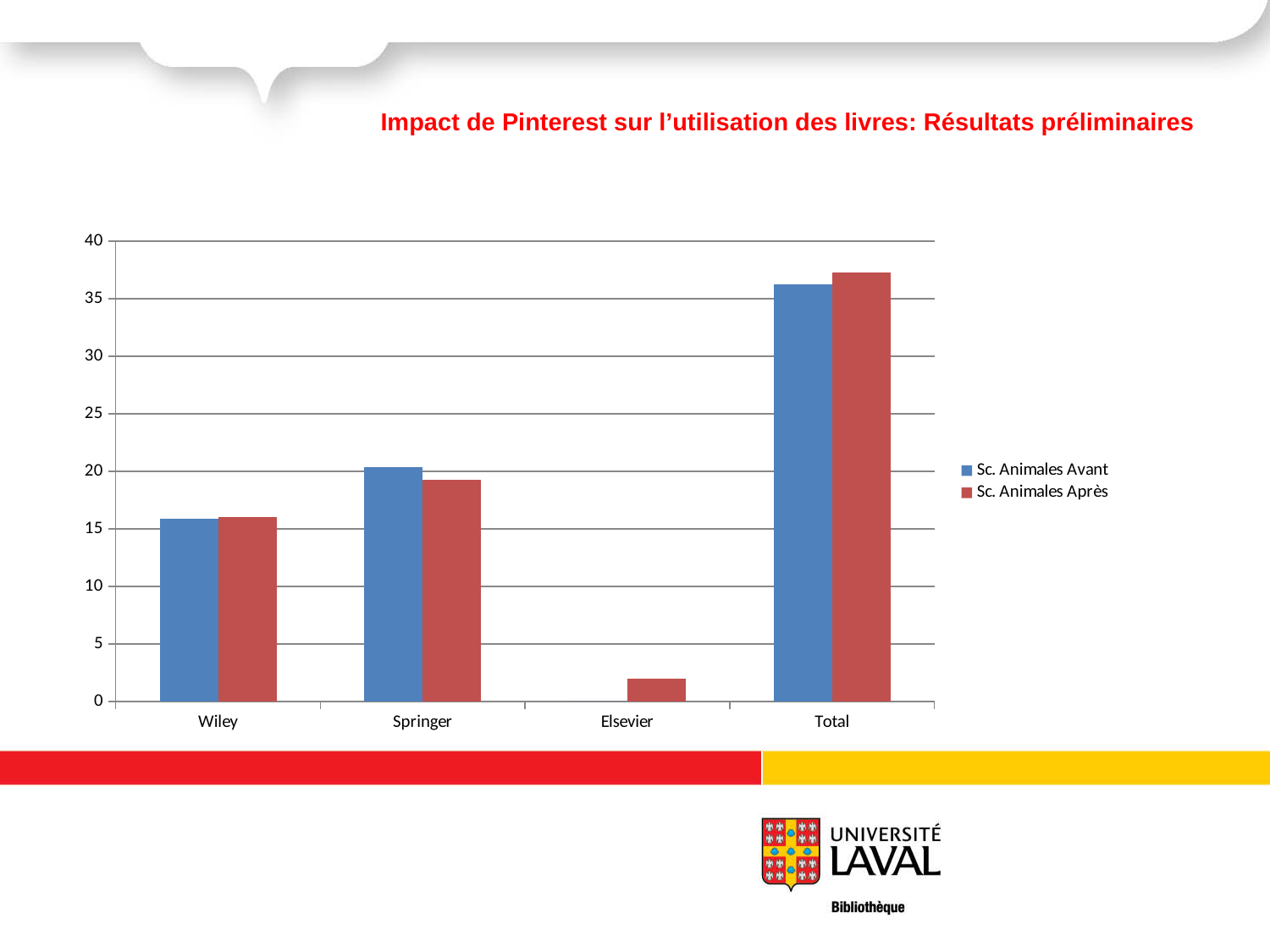
Which category has the highest value for Sc. Animales Avant? Total Which is larger: the Sc. Animales Après value for Total or the Sc. Animales Après value for Springer? Total What are the two series names listed in the chart's legend? Sc. Animales Avant and Sc. Animales Après Is the value for Wiley in the Sc. Animales Avant series greater or less than 20? less What kind of chart is shown on the slide? bar chart Is the value for Total in the Sc. Animales Avant series greater or less than 35? greater Which is larger: the Sc. Animales Avant value for Springer or the Sc. Animales Avant value for Wiley? Springer How many series does the chart's legend list? 2 Is the value for Elsevier in the Sc. Animales Après series greater or less than 5? less How many categories are shown on the x axis of the chart? 4 Which category has the lowest value for Sc. Animales Après? Elsevier